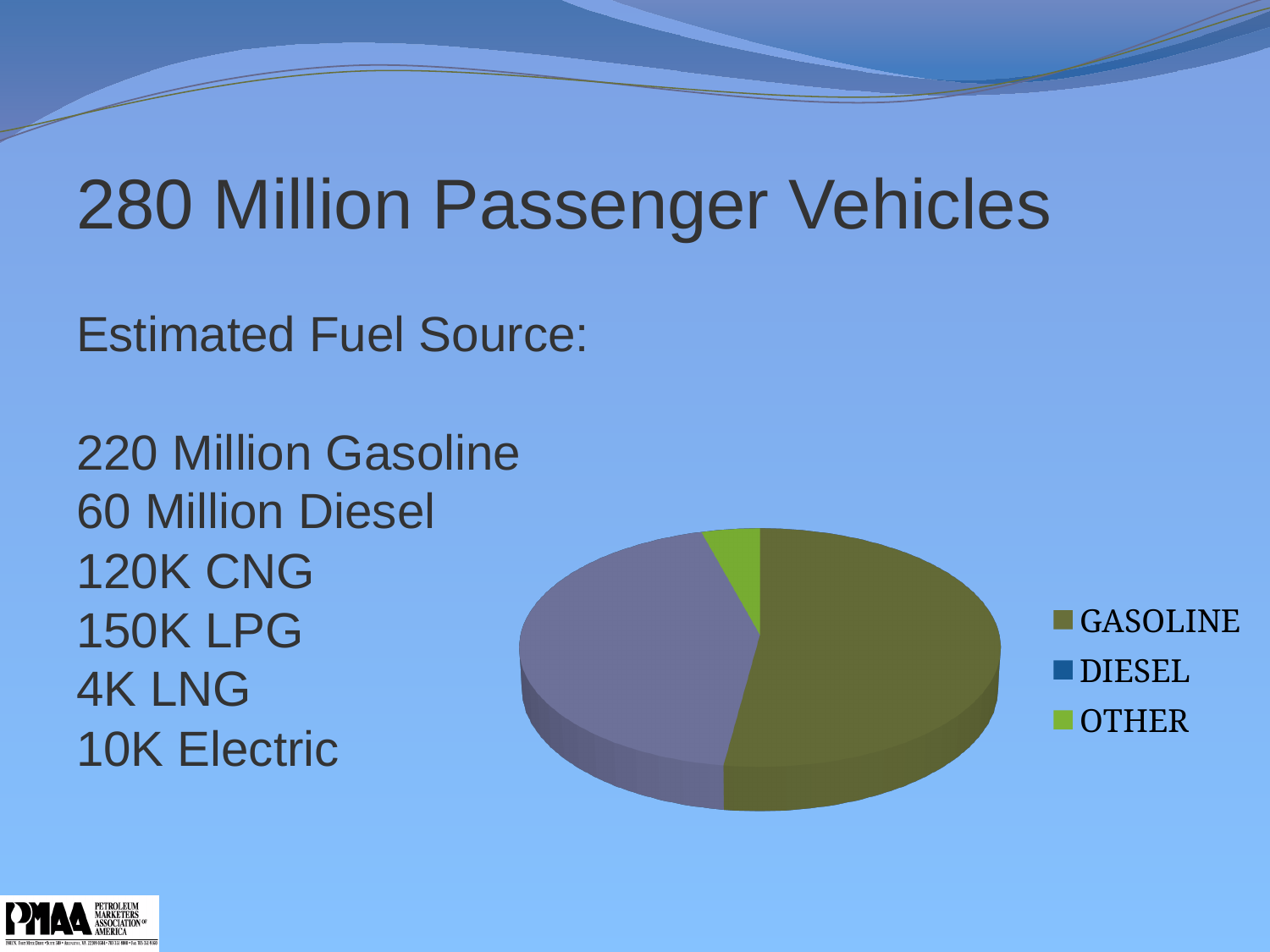
Which legend entry of the pie chart is shown in light green? OTHER Which category has the smallest slice in the pie chart? OTHER How many slices does the pie chart have? 3 What are the three categories listed in the pie chart's legend? GASOLINE, DIESEL, OTHER Which slice is smaller in the pie chart, GASOLINE or OTHER? OTHER Which category has the largest slice in the pie chart? GASOLINE How many entries does the legend of the pie chart list? 3 What kind of chart is shown on the slide? pie chart